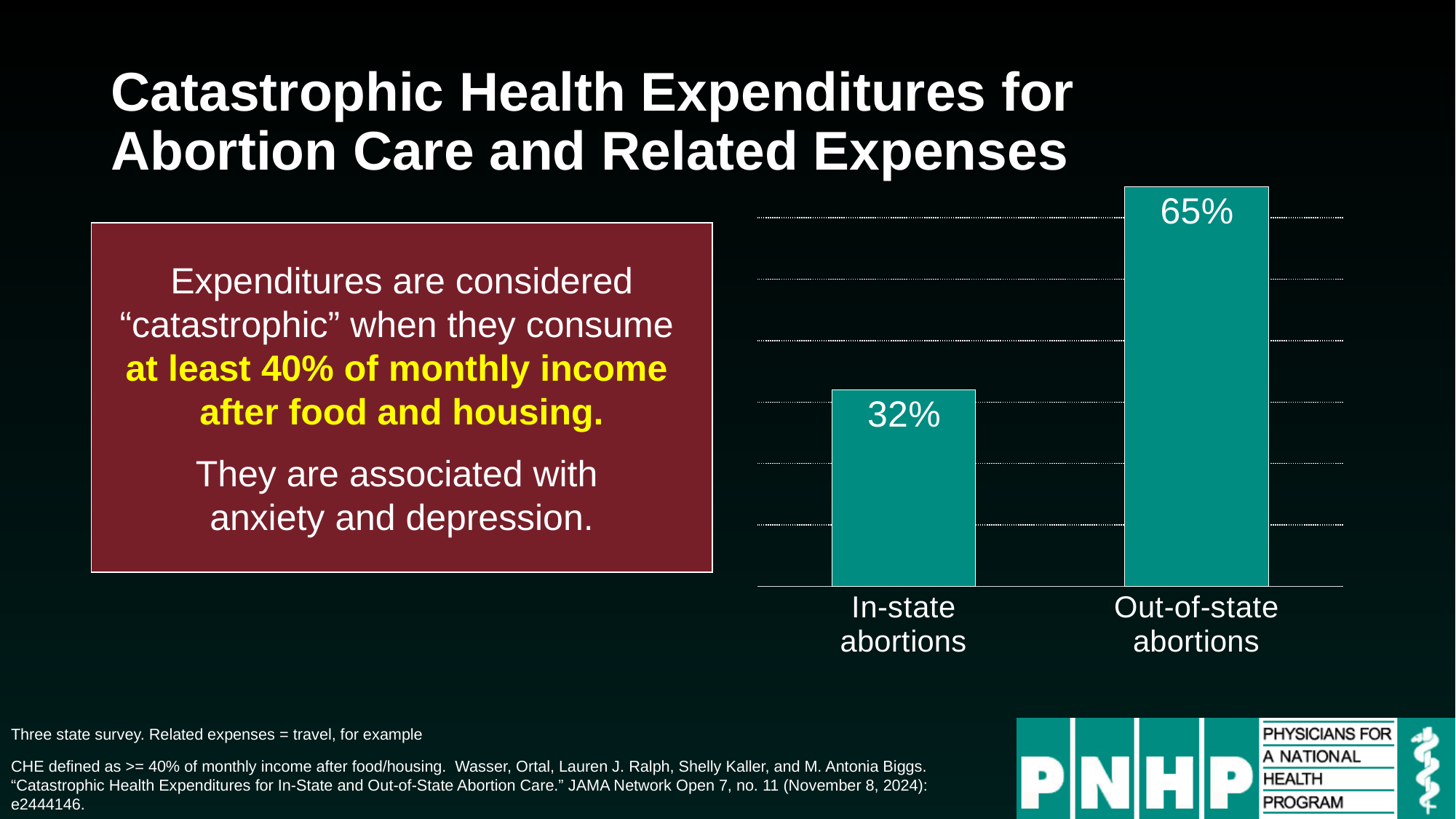
What is the difference between the values for Out-of-state abortions and In-state abortions? 33% Which category has the highest value? Out-of-state abortions Do the values rise or fall from In-state abortions to Out-of-state abortions? Rise Which category has the lowest value? In-state abortions What is the value for Out-of-state abortions? 65% Which is larger, the value for In-state abortions or the value for Out-of-state abortions? Out-of-state abortions How many categories are shown in the chart? 2 What is the title of the slide containing the chart? Catastrophic Health Expenditures for Abortion Care and Related Expenses What is the value for In-state abortions? 32% What kind of chart is shown on the slide? Bar chart What colour are the bars in the chart? Teal